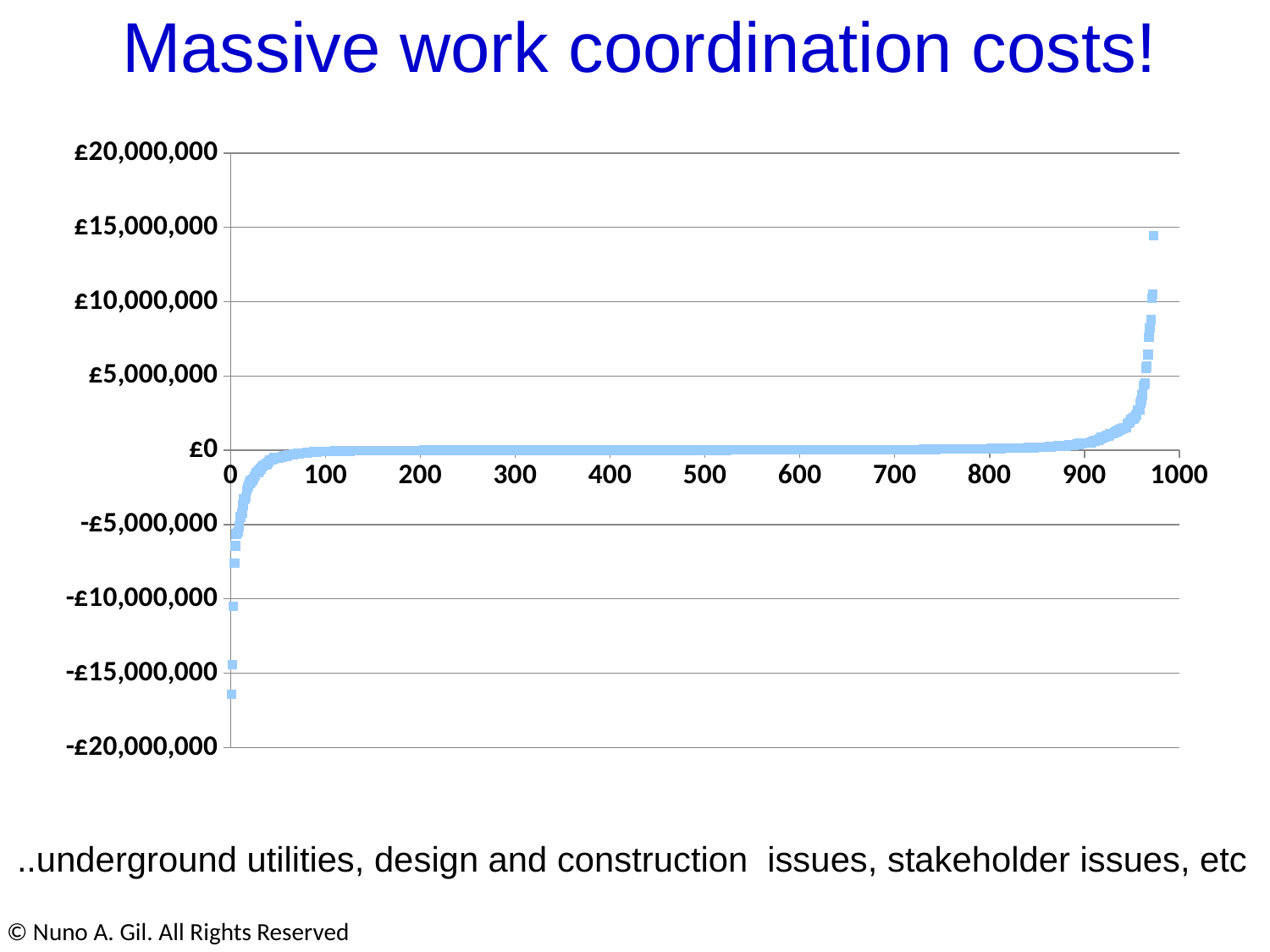
Is the highest plotted value greater or less than £15,000,000? less Is the highest plotted value greater or less than £10,000,000? greater Are the plotted values at x = 500 greater or less than £5,000,000? less What is the title of the slide containing the chart? Massive work coordination costs! Do the plotted values rise or fall as you move from left to right along the x axis? Rise Which is larger: the value of the rightmost plotted point or the value of the leftmost plotted point? The rightmost plotted point What is the highest value shown on the y axis? £20,000,000 What kind of chart is shown on the slide? Scatter chart